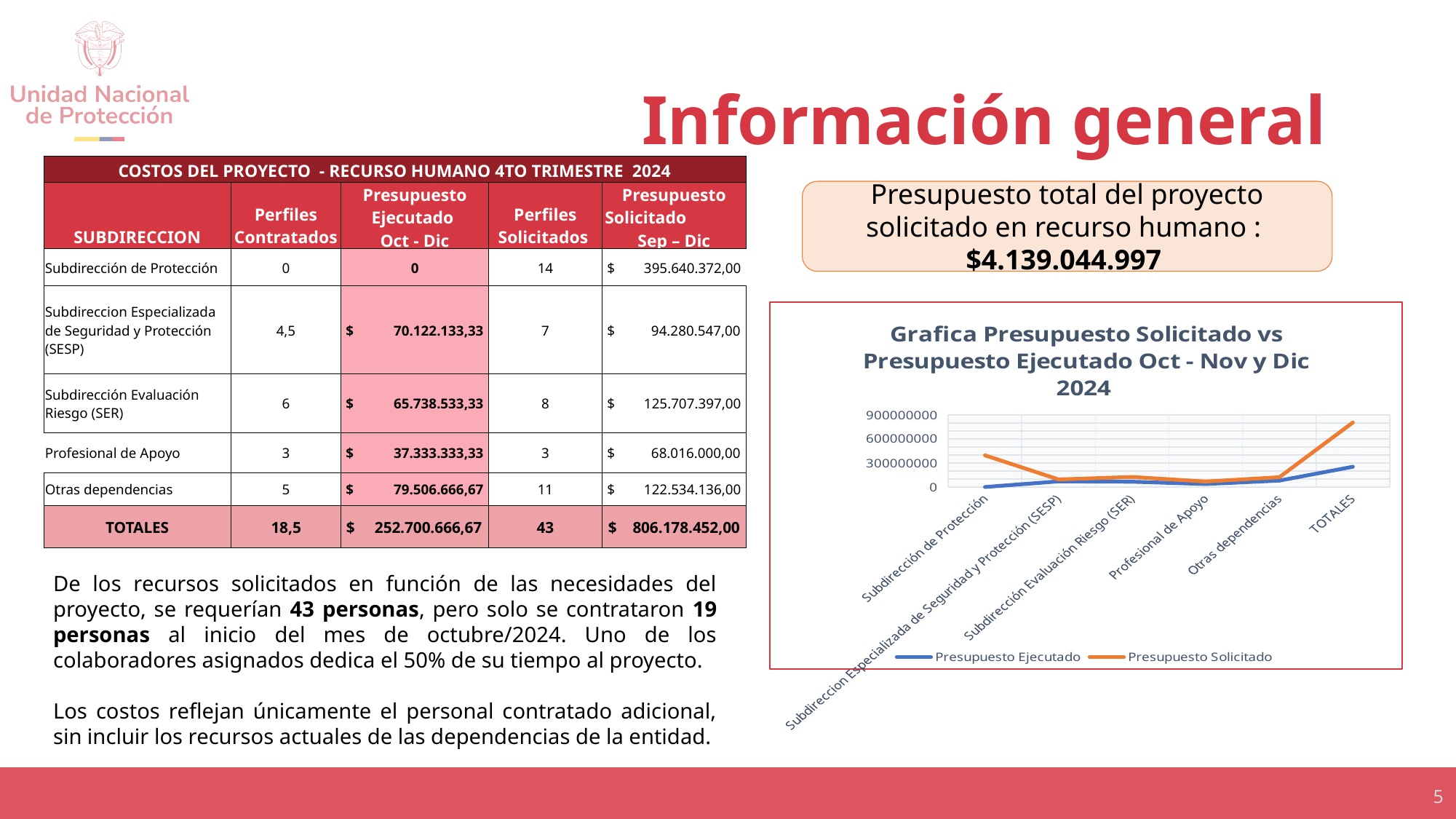
Which category has the lowest value for Presupuesto Ejecutado? Subdirección de Protección Is the Presupuesto Solicitado value for Profesional de Apoyo greater or less than 300000000? less Which series is drawn in orange in the chart? Presupuesto Solicitado How many categories are plotted along the x axis of the chart? 6 What kind of chart is shown on the slide? line chart Is the Presupuesto Solicitado value for TOTALES greater or less than 600000000? greater Does the Presupuesto Solicitado line rise or fall from Otras dependencias to TOTALES? rise How many series does the chart legend list? 2 Which category has the highest value for Presupuesto Solicitado? TOTALES Is the Presupuesto Solicitado value for Subdirección de Protección greater or less than 300000000? greater For TOTALES, which series has the larger value, Presupuesto Ejecutado or Presupuesto Solicitado? Presupuesto Solicitado